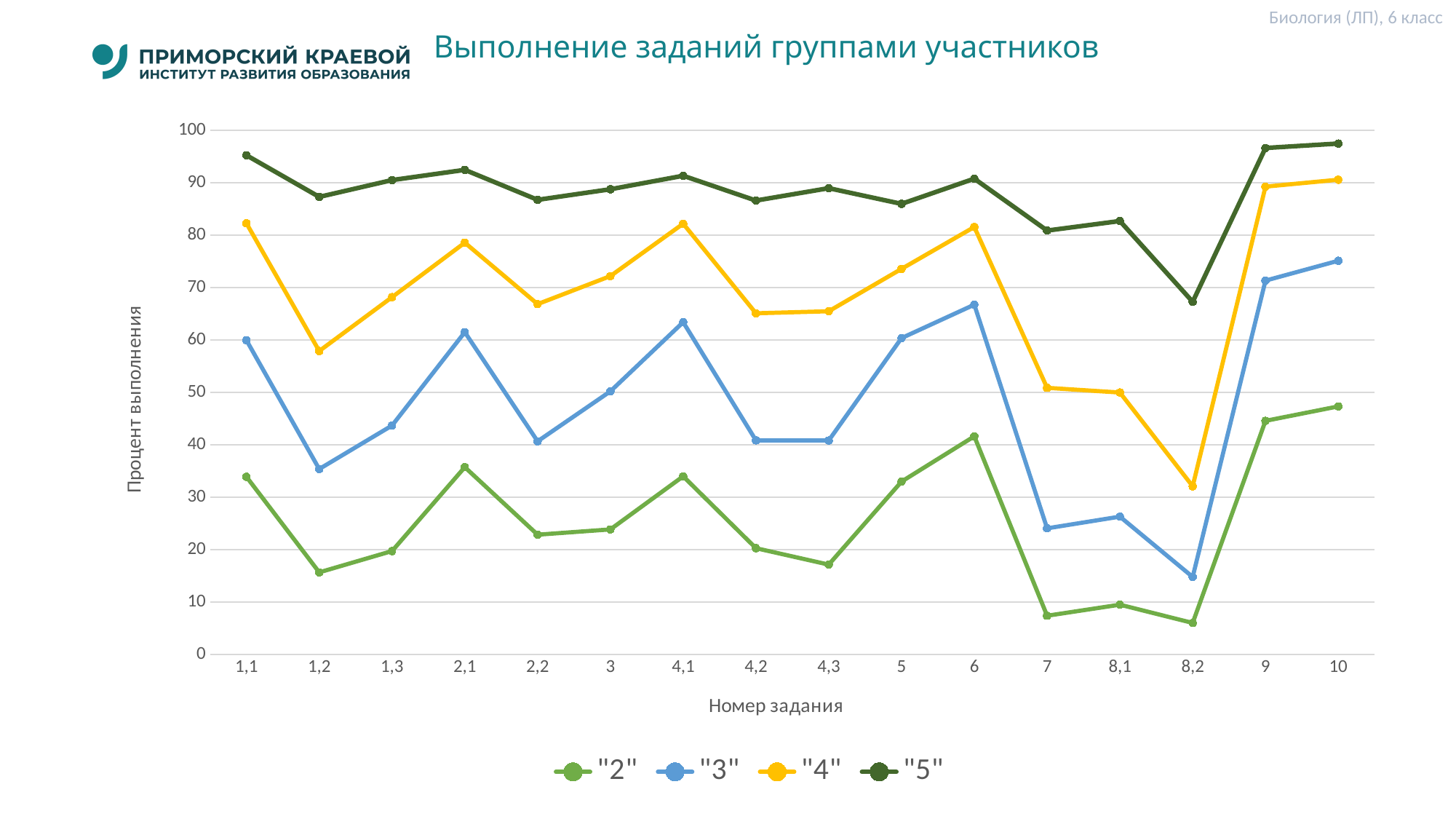
Does the value of series "3" rise or fall from task 6 to task 7? fall What is the title of the vertical axis? Процент выполнения How many series does the legend list? 4 What kind of chart is shown on the slide? Line chart For which task number is the value of series "5" lowest? 8,2 Which series has the larger value at task 7, "5" or "2"? "5" Is the value for series "5" at task 1,1 greater or less than 90? greater Is the value for series "4" at task 8,2 greater or less than 40? less For which task number is the value of series "3" highest? 10 How many task numbers are shown along the x axis? 16 Is the value for series "2" at task 7 greater or less than 10? less For which task number is the value of series "4" lowest? 8,2